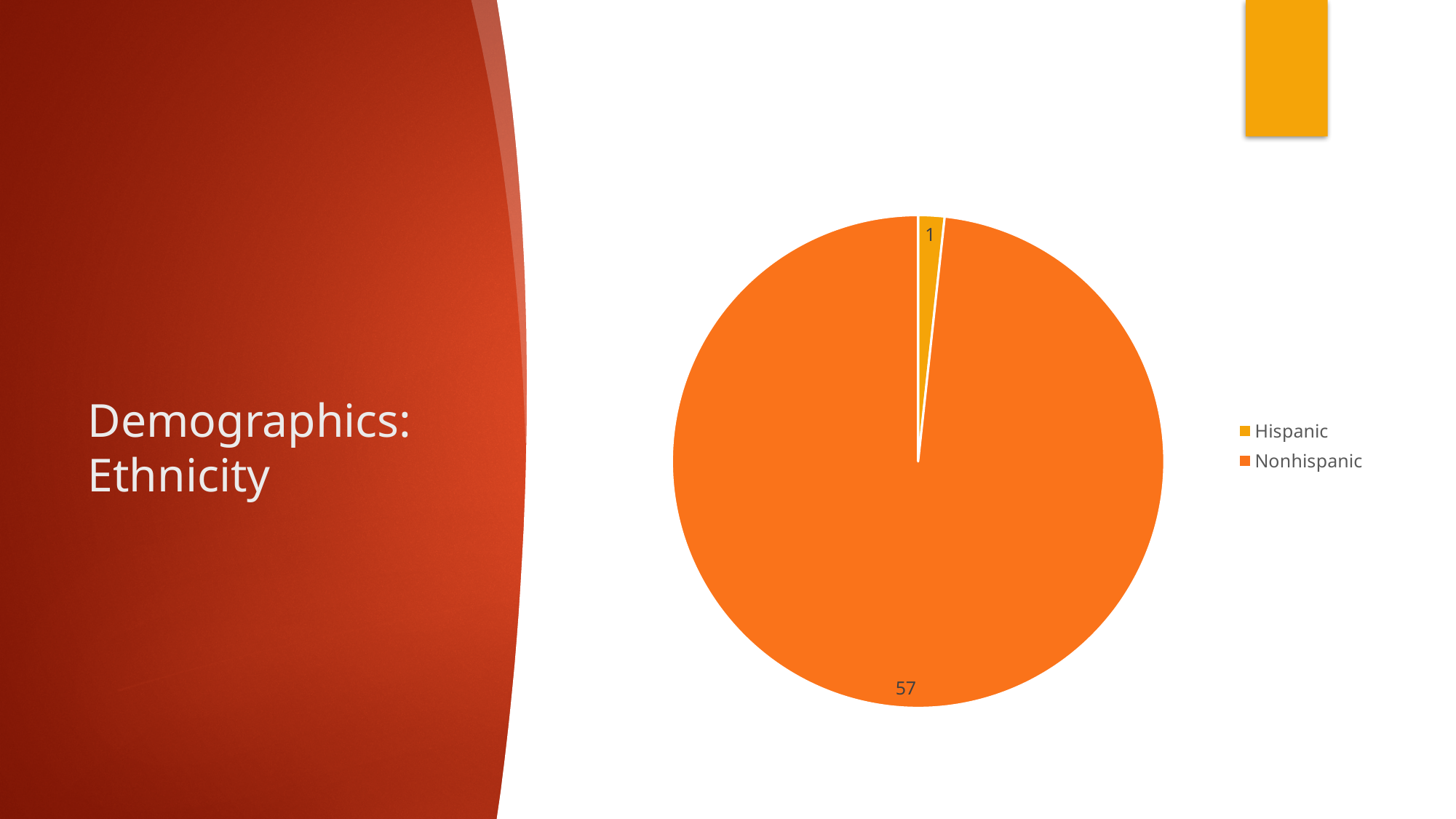
What colour is the Hispanic slice? yellow-orange How many categories does the pie chart show? 2 What is the total of all slices in the pie chart? 58 Which is larger, the value for Hispanic or the value for Nonhispanic? Nonhispanic What is the value for Nonhispanic? 57 How many entries does the legend list? 2 What kind of chart is shown on the slide? pie chart Which category has the largest slice? Nonhispanic Which category has the smallest slice? Hispanic What is the value for Hispanic? 1 What is the difference between the Nonhispanic and Hispanic values? 56 What is the title of the slide containing the chart? Demographics: Ethnicity